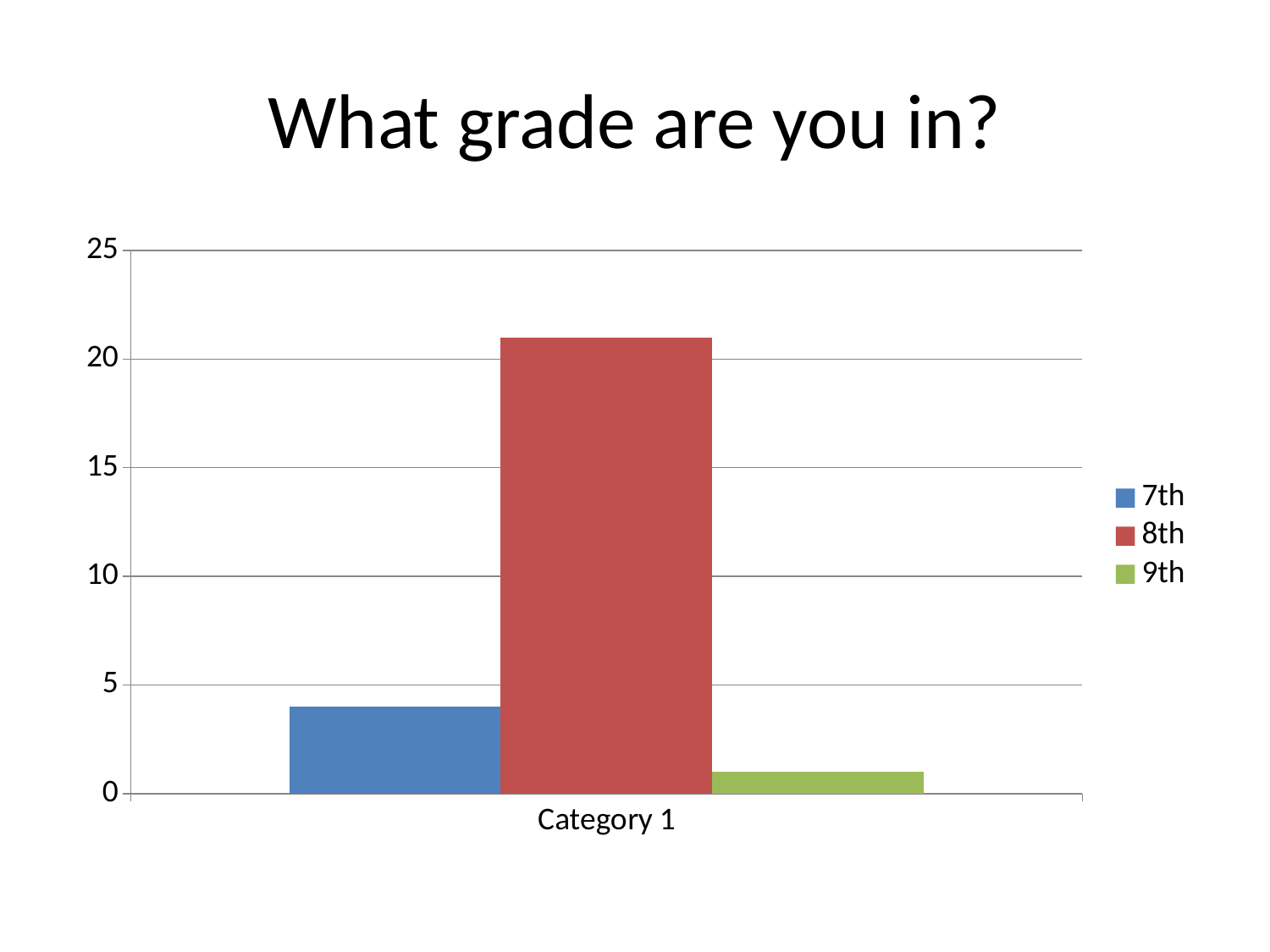
How many categories are shown on the x axis? 1 Which series has the highest bar? 8th Which is larger, the value for 8th or the value for 7th? 8th Which series has the lowest bar? 9th What is the title of the slide? What grade are you in? Is the value for 7th greater or less than 5? less Which is larger, the value for 7th or the value for 9th? 7th How many series does the legend list? 3 What are the entries listed in the legend? 7th, 8th, 9th What kind of chart is shown on the slide? bar chart Is the value for 9th greater or less than 5? less Is the value for 8th greater or less than 20? greater